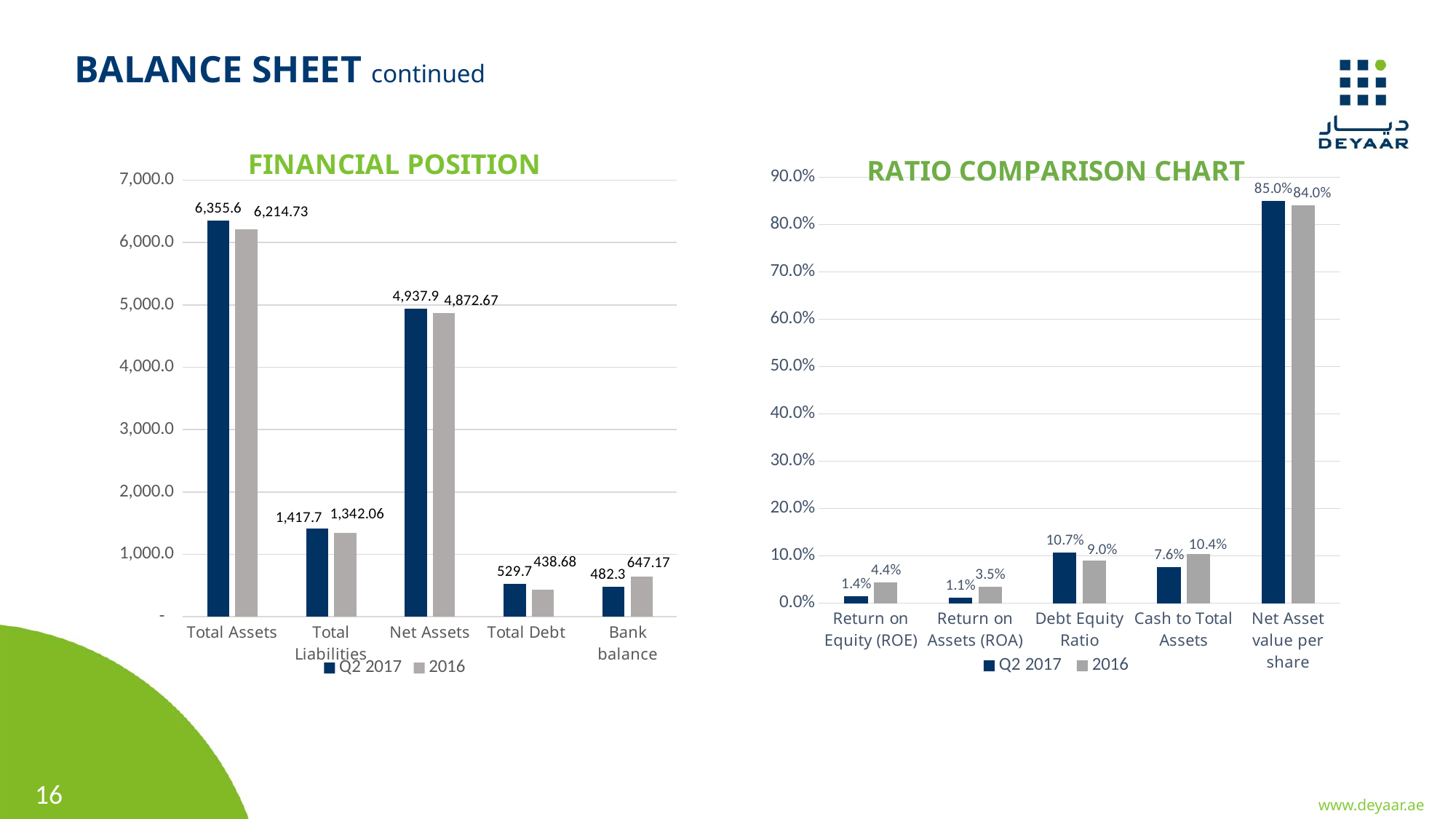
In the FINANCIAL POSITION chart, is the Q2 2017 value for Bank balance larger or smaller than the 2016 value? smaller In the FINANCIAL POSITION chart, which category has the highest Q2 2017 value? Total Assets In the FINANCIAL POSITION chart, what is the difference between the Q2 2017 and 2016 values for Total Liabilities? 75.64 In the RATIO COMPARISON CHART, what is the difference between the Q2 2017 and 2016 values for Net Asset value per share? 1.0% In the RATIO COMPARISON CHART, what is the Q2 2017 value for Debt Equity Ratio? 10.7% In the FINANCIAL POSITION chart, what is the Q2 2017 value for Total Assets? 6,355.6 How many categories are shown on the x axis of the FINANCIAL POSITION chart? 5 In the FINANCIAL POSITION chart, what is the 2016 value for Bank balance? 647.17 In the RATIO COMPARISON CHART, what is the 2016 value for Return on Equity (ROE)? 4.4% In the FINANCIAL POSITION chart, which category has the lowest 2016 value? Total Debt How many series does the legend of the RATIO COMPARISON CHART list? 2 In the RATIO COMPARISON CHART, which category has the lowest Q2 2017 value? Return on Assets (ROA)